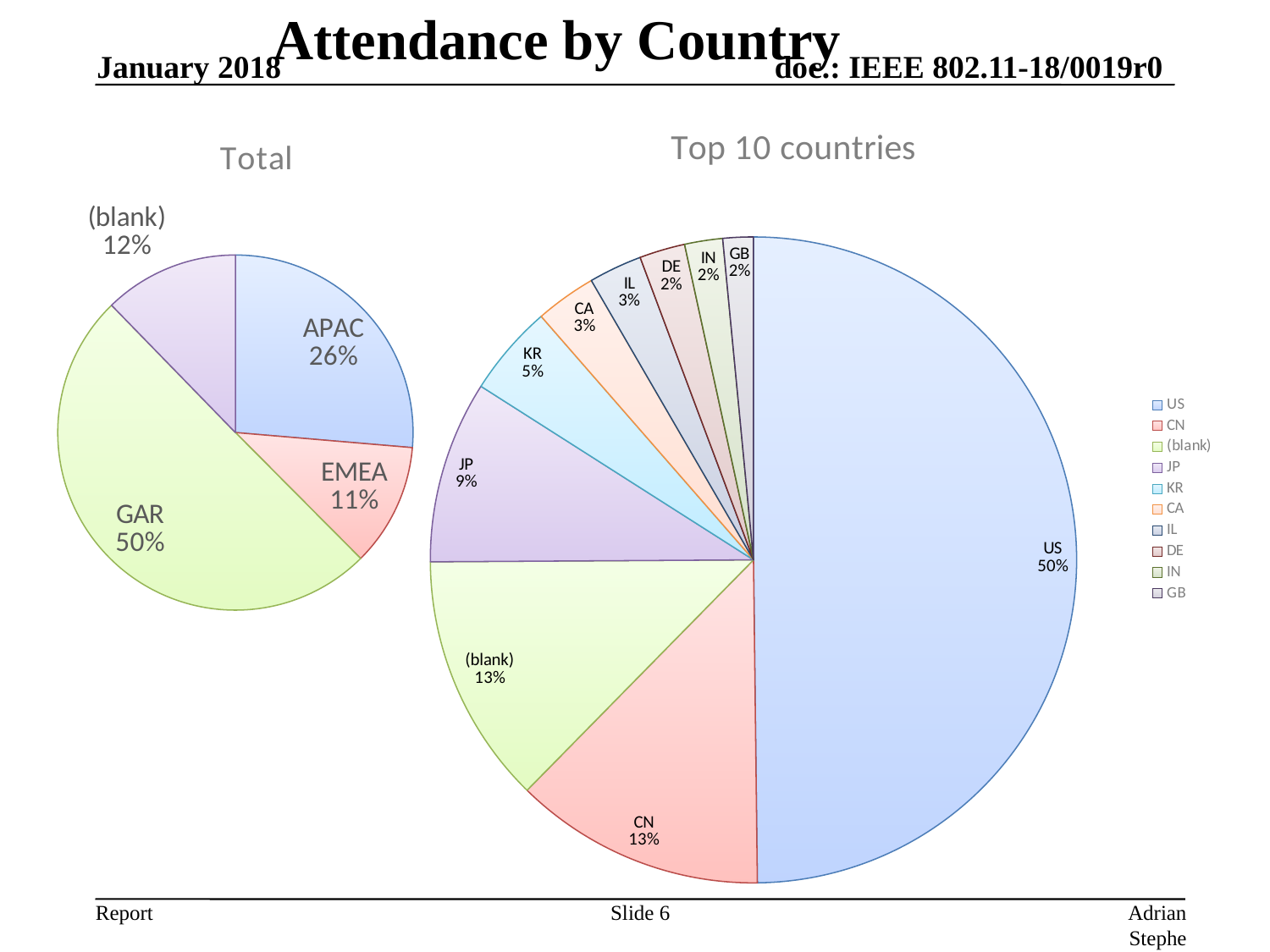
How many entries does the legend of the 'Top 10 countries' chart list? 10 In the 'Top 10 countries' chart, which country has the largest share? US In the 'Total' chart, how many slices are there? 4 In the 'Top 10 countries' chart, which has the larger share, JP or CA? JP What kind of chart is the 'Top 10 countries' chart? Pie chart In the 'Top 10 countries' chart, what share does JP have? 9% In the 'Top 10 countries' chart, what is the difference between the shares of CN and KR? 8% In the 'Top 10 countries' chart, what share does US have? 50% In the 'Total' chart, which category has the smallest share? EMEA In the 'Total' chart, what share does APAC have? 26% In the 'Total' chart, what is the difference between the shares of GAR and (blank)? 38%